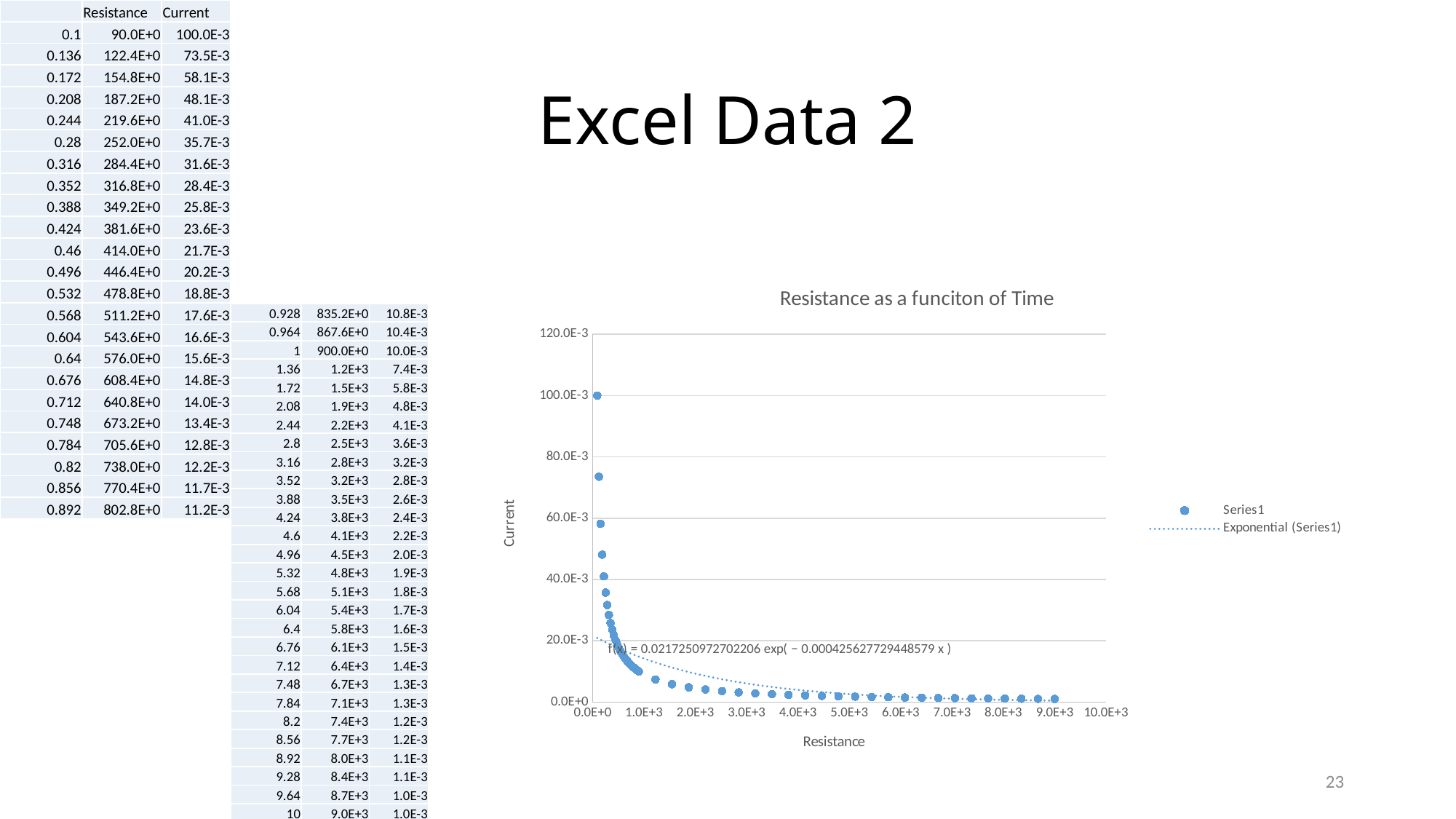
What kind of chart is shown on the slide? scatter chart How many entries does the chart legend list? 2 Do the Current values rise or fall as Resistance increases along the x axis? fall Is the Current value of the point at a Resistance of about 1.0E+3 greater or less than 20.0E-3? less What is the title of the chart? Resistance as a funciton of Time Is the Current value of the highest plotted point greater or less than 80.0E-3? greater What is the Current value of the highest plotted point, which lies on a y-axis tick? 100.0E-3 Is the Current value of the second-highest plotted point greater or less than 80.0E-3? less Which has the larger Current value: the point nearest a Resistance of 0.0E+0 or the point nearest a Resistance of 9.0E+3? the point nearest 0.0E+0 What type of trendline is fitted to Series1 according to the legend? Exponential